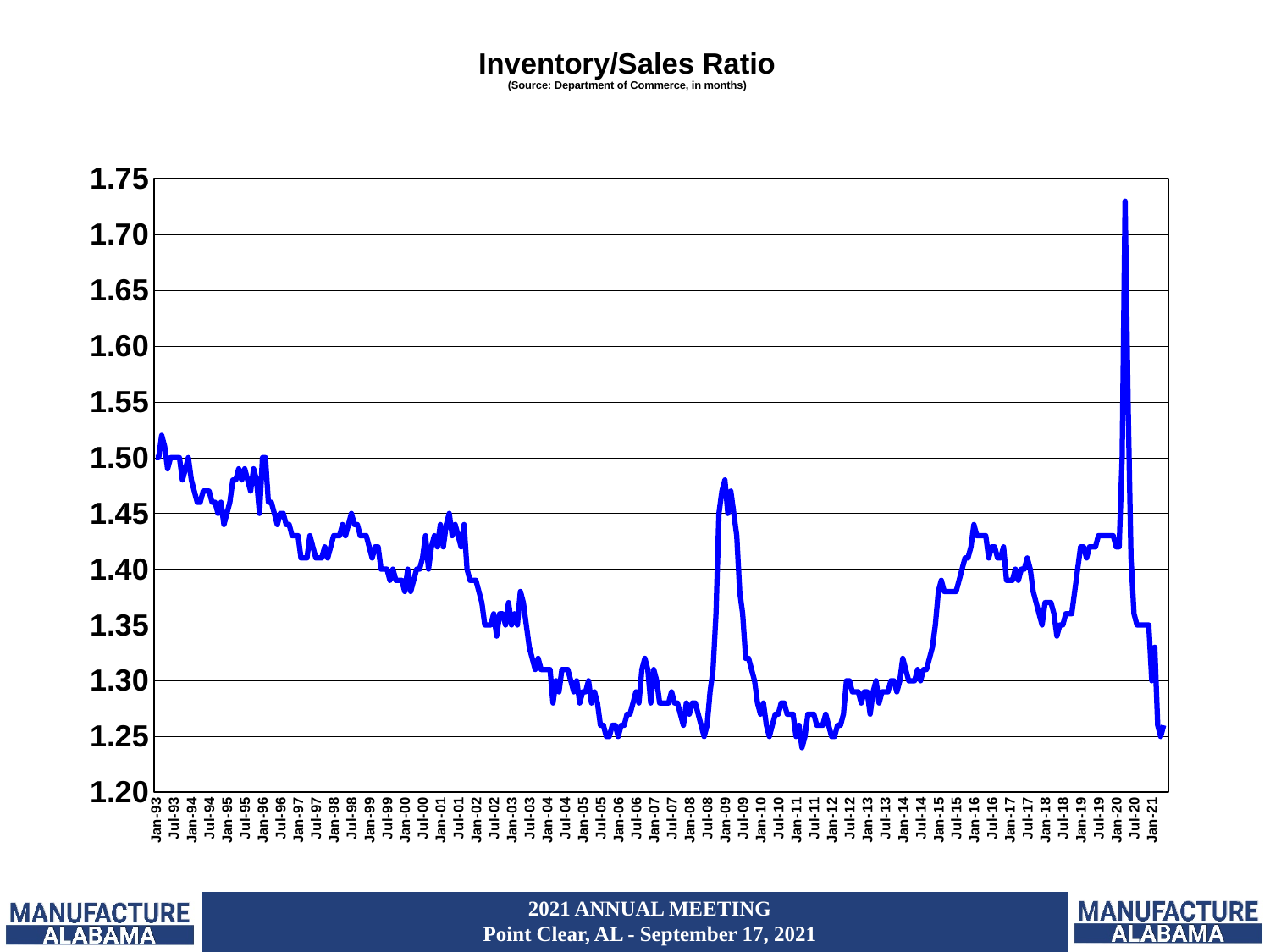
Is the Inventory/Sales Ratio at Jan-93 greater or less than 1.45? greater Which is larger, the Inventory/Sales Ratio at Jan-93 or at Jan-11? Jan-93 Which peak is higher, the one around Jan-09 or the one in 2020? 2020 Does the Inventory/Sales Ratio generally rise or fall between Jan-93 and Jan-00? fall What kind of chart is shown on the slide? line chart What is the title of the chart? Inventory/Sales Ratio In which year does the Inventory/Sales Ratio reach its highest peak? 2020 Is the Inventory/Sales Ratio at Jan-16 greater or less than 1.40? greater Is the peak value of the Inventory/Sales Ratio in 2020 greater or less than 1.70? greater According to the subtitle, what is the source of the data and in what units is it measured? Department of Commerce, in months